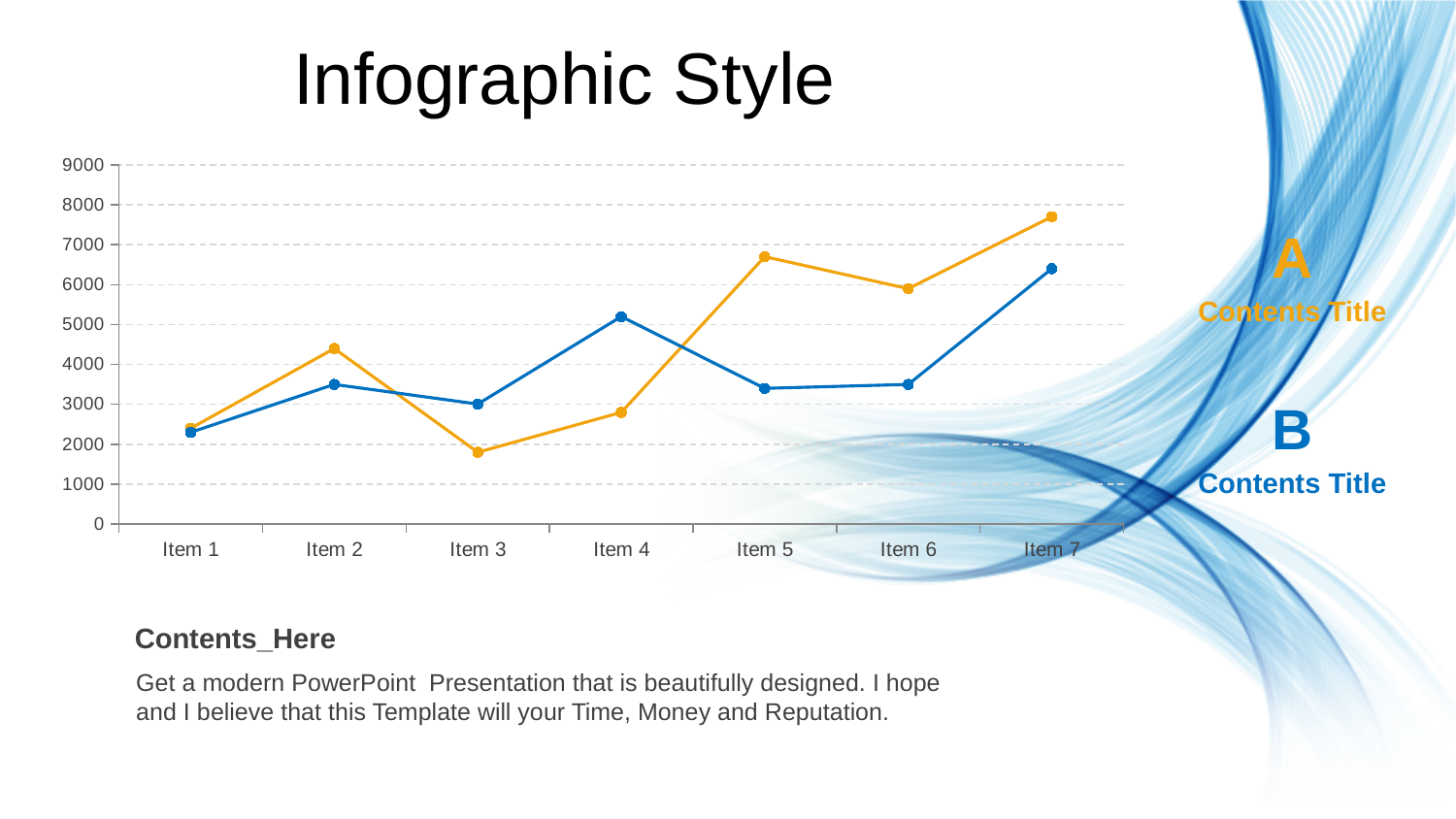
How many lines are plotted on the chart? 2 Does the orange line rise or fall from Item 4 to Item 5? rise Is the value of the blue line at Item 1 greater or less than 3000? less Is the value of the blue line at Item 4 greater or less than 5000? greater Is the value of the orange line at Item 7 greater or less than 7000? greater How many categories are shown on the x axis of the chart? 7 At which item does the orange line reach its highest value? Item 7 What kind of chart is shown on the slide? line chart At which item does the orange line reach its lowest value? Item 3 At Item 5, which line has the higher value, the orange line or the blue line? orange line At which item does the blue line reach its highest value? Item 7